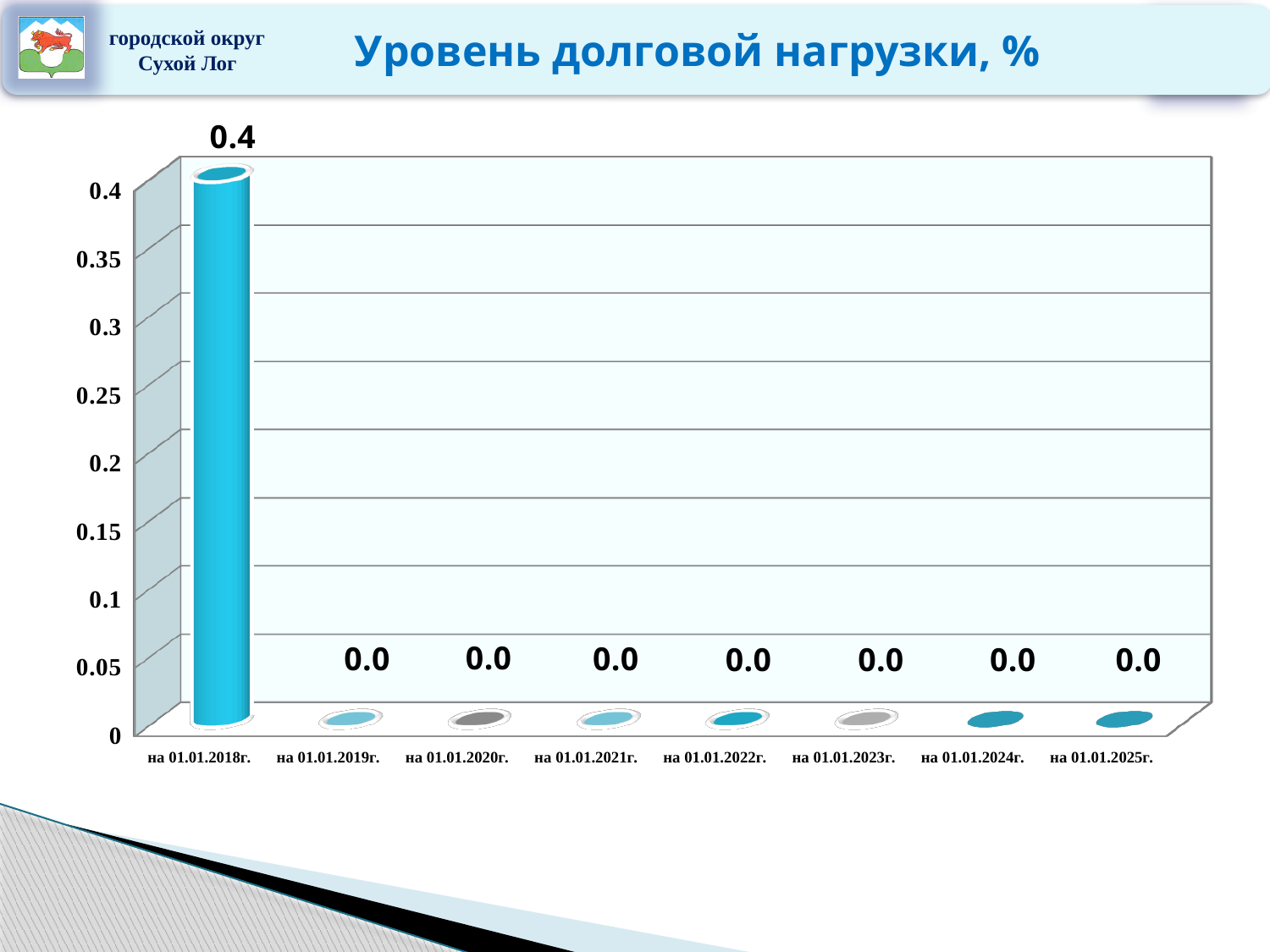
What kind of chart is shown on the slide? bar chart How many categories have a value of 0.0? 7 Which category has the highest value? на 01.01.2018г. How many categories are shown on the x axis? 8 Do the values rise or fall from на 01.01.2018г. to на 01.01.2019г.? fall What is the value for на 01.01.2025г.? 0.0 What is the value for на 01.01.2018г.? 0.4 Which is larger, the value for на 01.01.2018г. or the value for на 01.01.2023г.? на 01.01.2018г. Is the value for на 01.01.2018г. greater or less than 0.3? greater What is the value for на 01.01.2021г.? 0.0 What is the title of the chart? Уровень долговой нагрузки, % What is the difference between the values for на 01.01.2018г. and на 01.01.2019г.? 0.4